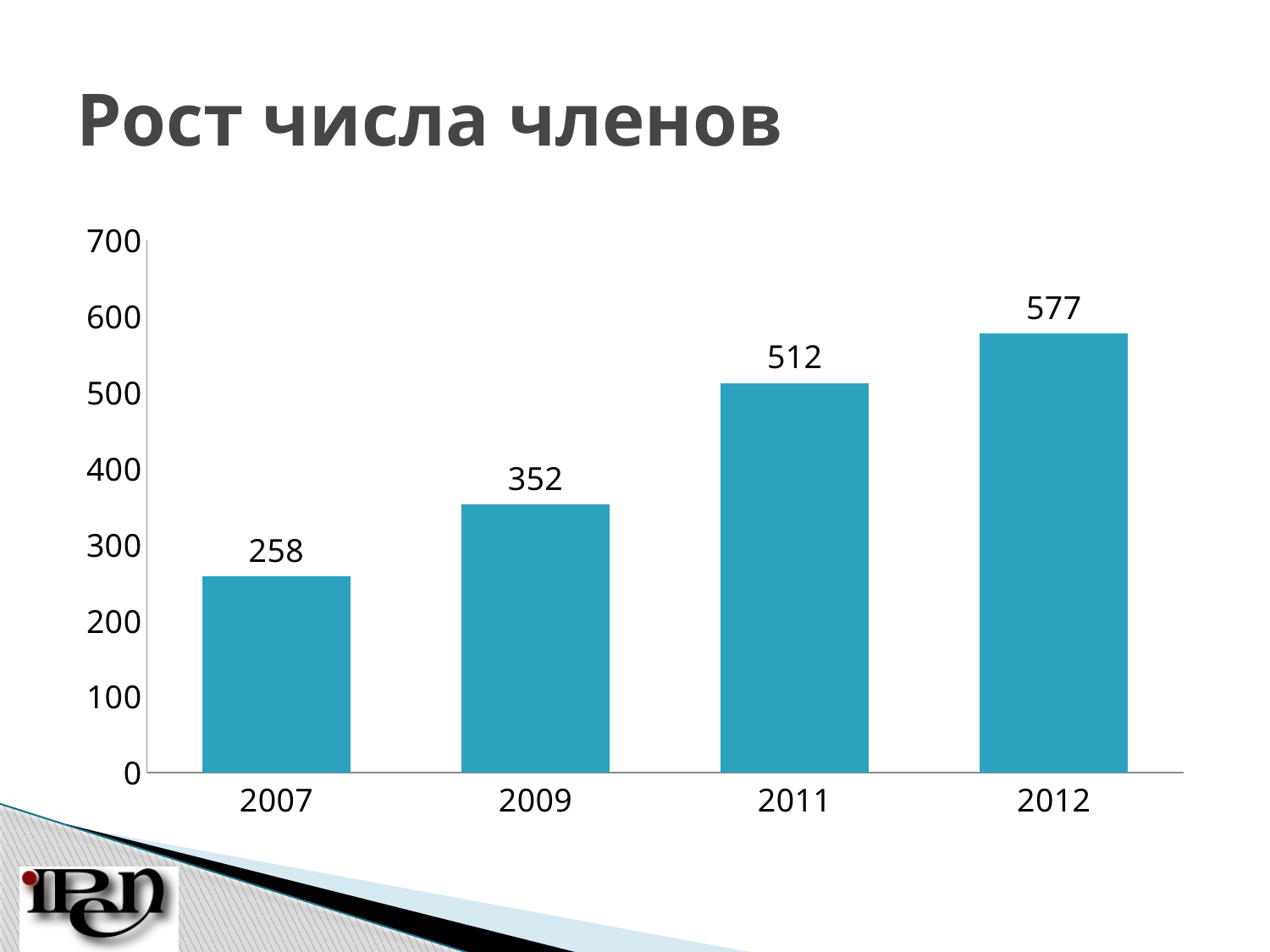
What is the value for 2007? 258 Which is larger, the value for 2009 or the value for 2011? 2011 What is the value for 2009? 352 What is the difference between the values for 2011 and 2009? 160 Which year has the lowest value? 2007 Do the values rise or fall from 2007 to 2012? rise How many years are shown on the x axis? 4 What is the value for 2011? 512 Which year has the highest value? 2012 What kind of chart is shown on the slide? bar chart What is the difference between the values for 2012 and 2007? 319 What is the value for 2012? 577